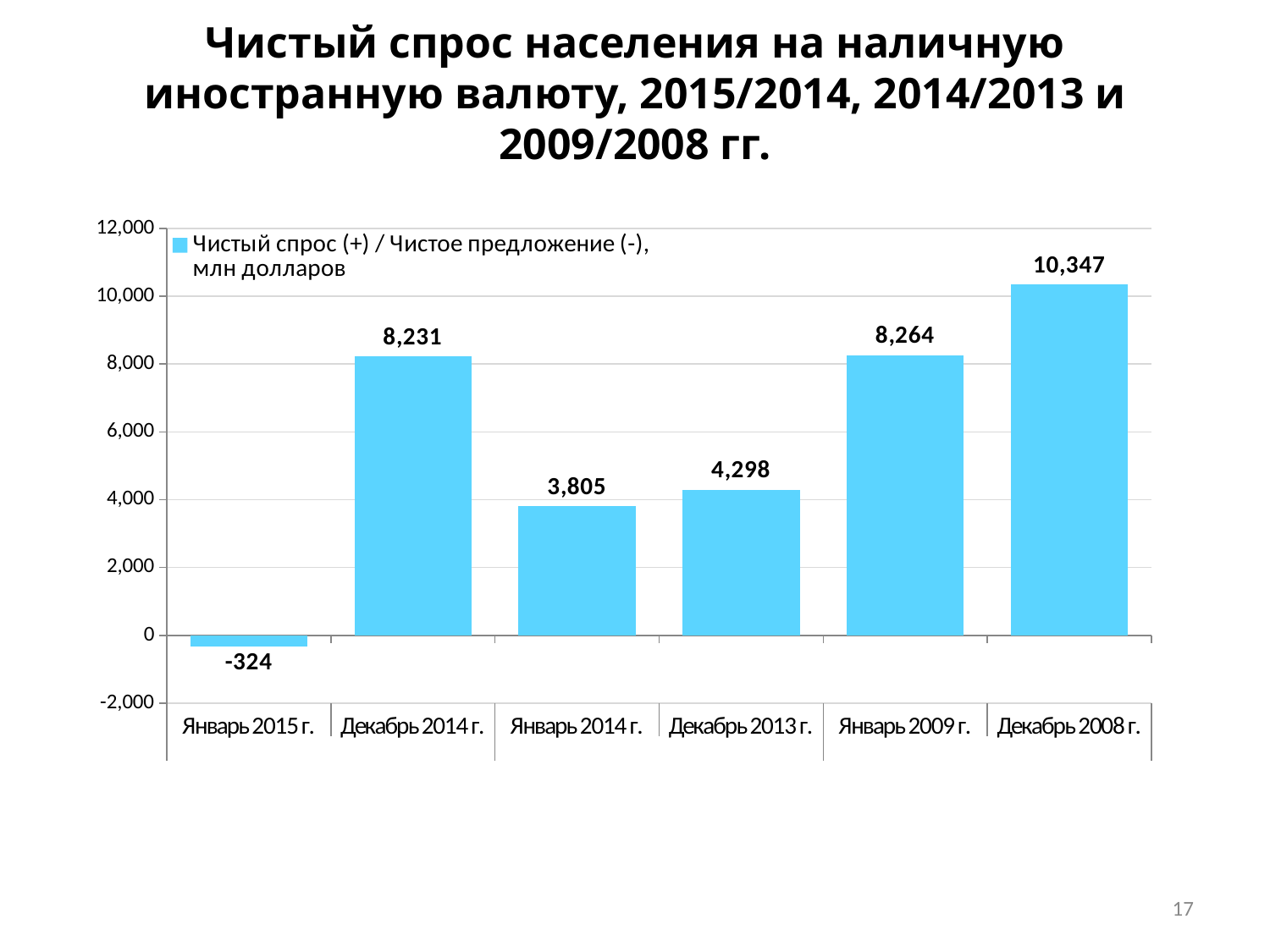
What kind of chart is shown on the slide? bar chart What series name does the legend show? Чистый спрос (+) / Чистое предложение (-), млн долларов How many categories are shown on the x axis? 6 Is the value for Декабрь 2013 г. greater or less than 6,000? less What is the value for Январь 2015 г.? -324 What is the value for Январь 2014 г.? 3,805 What is the value for Декабрь 2008 г.? 10,347 Which category has the highest value? Декабрь 2008 г. What is the value for Декабрь 2014 г.? 8,231 What is the difference between the values for Декабрь 2013 г. and Январь 2014 г.? 493 Which is larger, the value for Январь 2009 г. or the value for Декабрь 2014 г.? Январь 2009 г. Which category has the lowest value? Январь 2015 г.